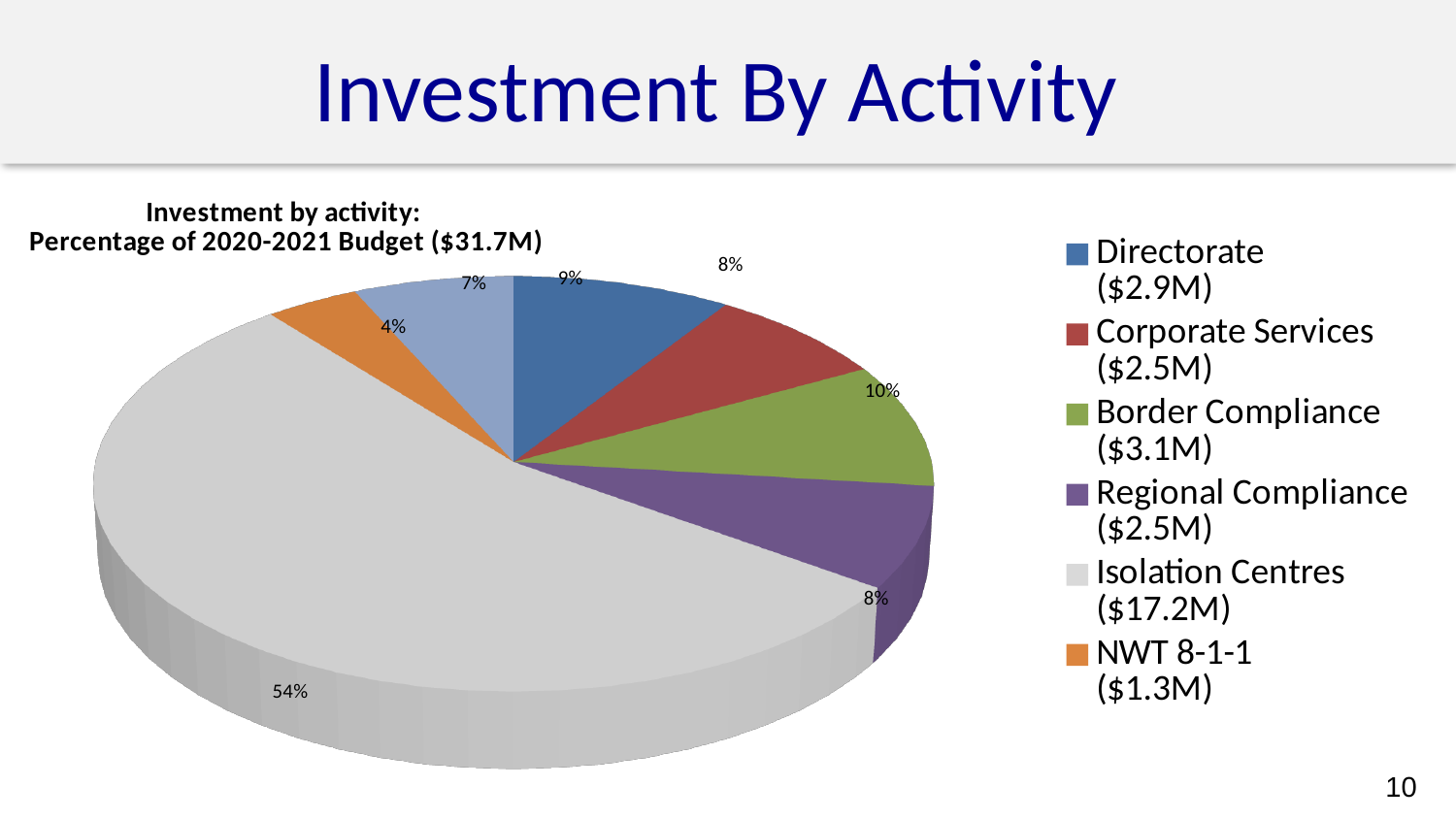
What percentage of the budget goes to NWT 8-1-1? 4% Which has a larger share of the pie, Border Compliance or Directorate? Border Compliance How many percentage points larger is the Isolation Centres share than the Border Compliance share? 44 What percentage of the budget goes to Border Compliance? 10% Which activity has the largest share of the pie? Isolation Centres Which activity has the smallest share of the pie? NWT 8-1-1 According to the legend, what is the dollar amount for Isolation Centres? $17.2M How many entries does the legend list? 6 What percentage of the budget goes to Isolation Centres? 54% What total budget amount is given in the chart title? $31.7M What kind of chart is shown on the slide? pie chart What percentage of the budget goes to Directorate? 9%